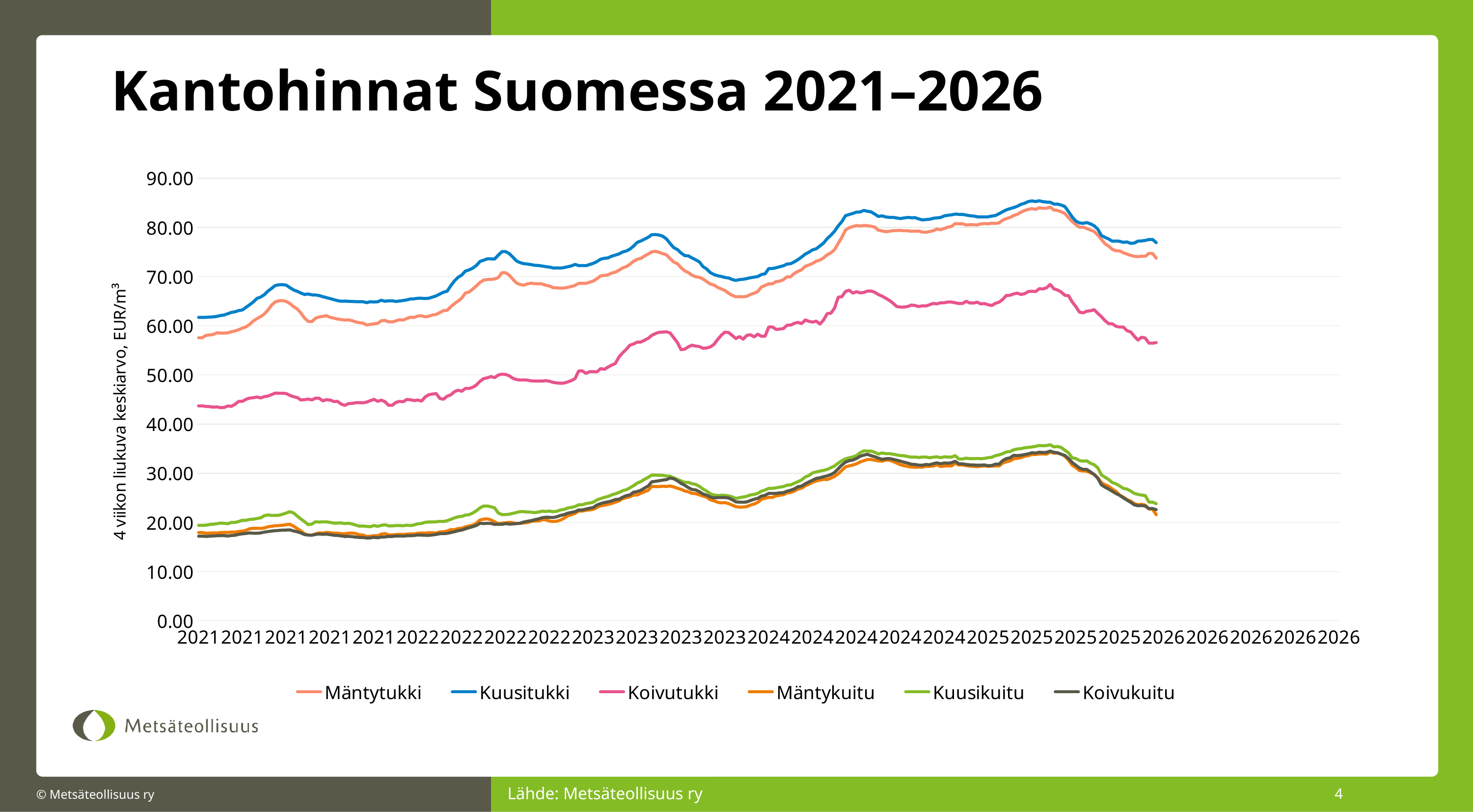
Does the Kuusitukki series rise or fall from its 2025 peak to the end of the series in 2026? fall Does the Koivutukki series rise or fall from 2021 to its 2025 peak? rise Which series has the highest values across the whole period? Kuusitukki Is the value of Kuusikuitu at the start of 2021 greater or less than 30? less What kind of chart is shown on the slide? line chart What is the title of the chart? Kantohinnat Suomessa 2021–2026 Is the peak value of Kuusitukki in 2025 greater or less than 80? greater Is the value of Koivutukki at the start of 2021 greater or less than 50? less How many series does the legend list? 6 At the start of 2021, which is larger, Kuusikuitu or Mäntykuitu? Kuusikuitu What is the label of the vertical axis? 4 viikon liukuva keskiarvo, EUR/m³